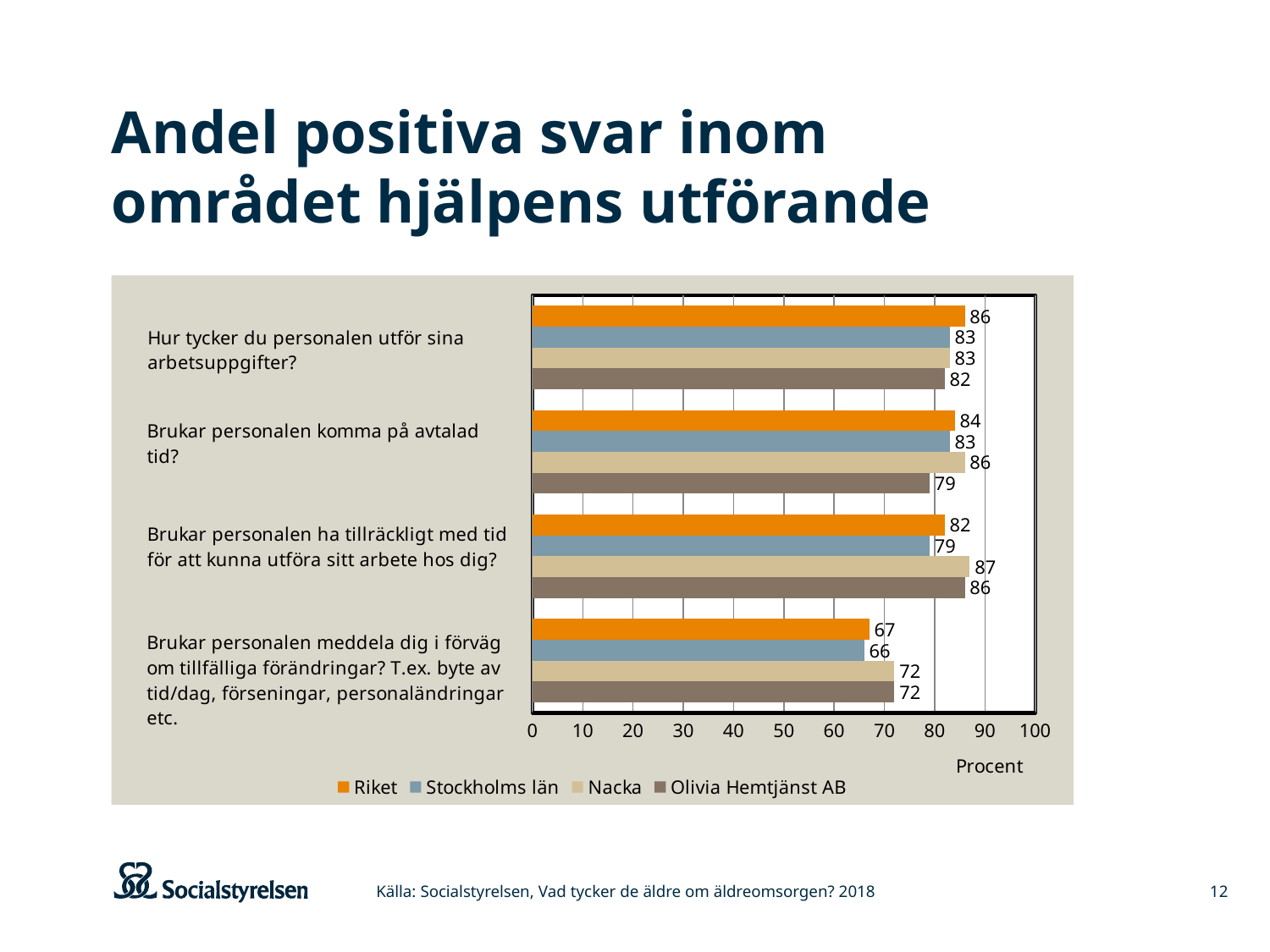
What label is shown on the horizontal axis of the chart? Procent Which series has the lowest value for "Brukar personalen ha tillräckligt med tid för att kunna utföra sitt arbete hos dig?"? Stockholms län What is the difference between the Riket value and the Stockholms län value for "Hur tycker du personalen utför sina arbetsuppgifter?"? 3 What is the value for Nacka for "Brukar personalen ha tillräckligt med tid för att kunna utföra sitt arbete hos dig?"? 87 How many series does the legend list? 4 What kind of chart is shown on the slide? Bar chart What is the value for Riket for "Hur tycker du personalen utför sina arbetsuppgifter?"? 86 Which series has the highest value for "Brukar personalen komma på avtalad tid?"? Nacka What is the value for Olivia Hemtjänst AB for "Brukar personalen komma på avtalad tid?"? 79 What is the value for Stockholms län for "Brukar personalen meddela dig i förväg om tillfälliga förändringar?"? 66 How many question categories are plotted on the chart? 4 For "Brukar personalen meddela dig i förväg om tillfälliga förändringar?", which is larger: the value for Nacka or the value for Riket? Nacka